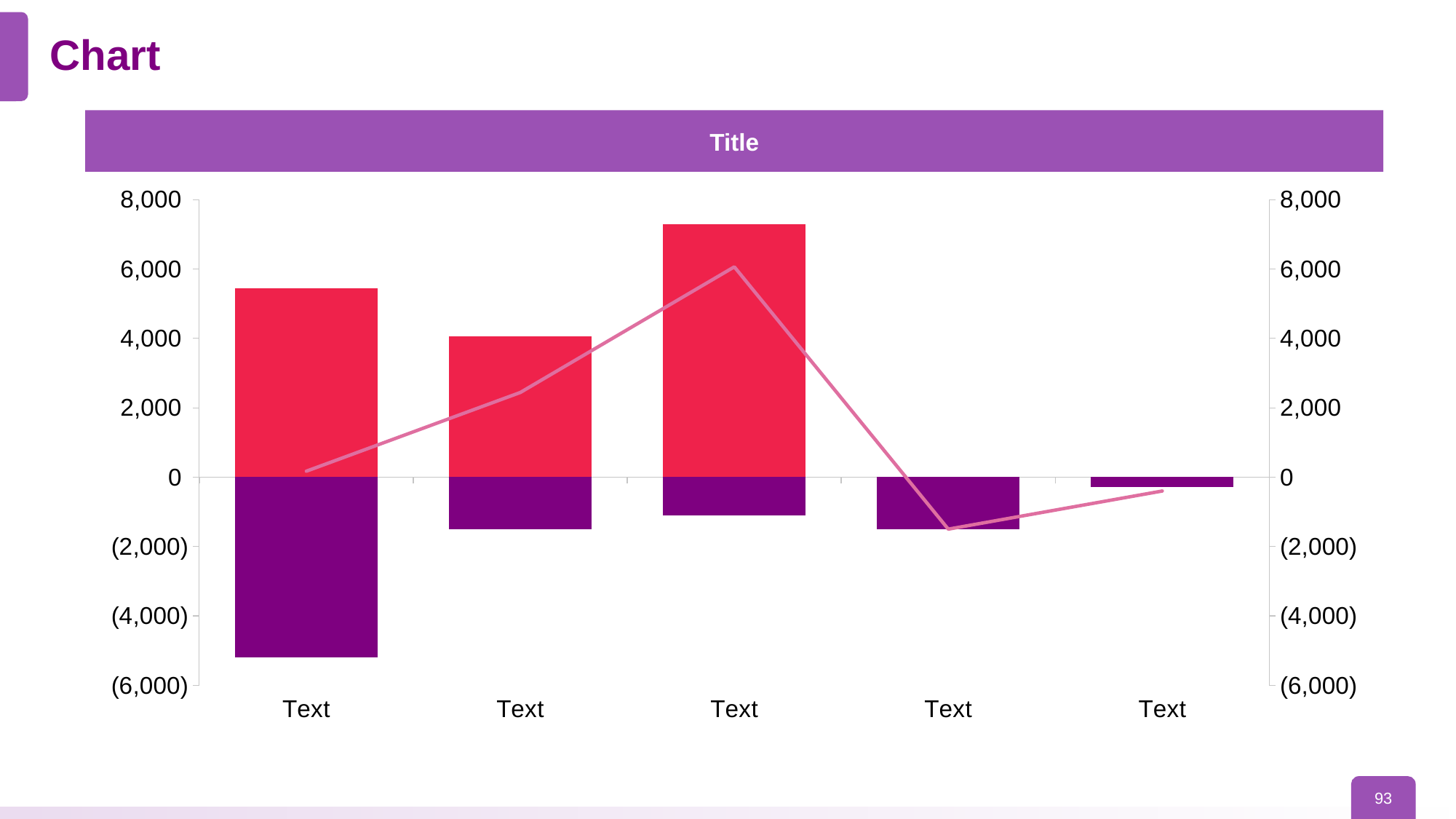
What kind of chart is shown on the slide? A bar chart combined with a line Which red bar is taller, the first category or the second category? The first category Is the red bar for the first category greater or less than 6,000? less Is the red bar for the third category greater or less than 6,000? greater Is the line value at the fourth category greater or less than 0? less Which category has the tallest red (positive) bar? The third category from the left Does the line rise or fall from the first category to the third category? rises What is the title shown above the chart? Title Which category has the longest purple (negative) bar? The first category from the left How many categories are shown along the x axis? 5